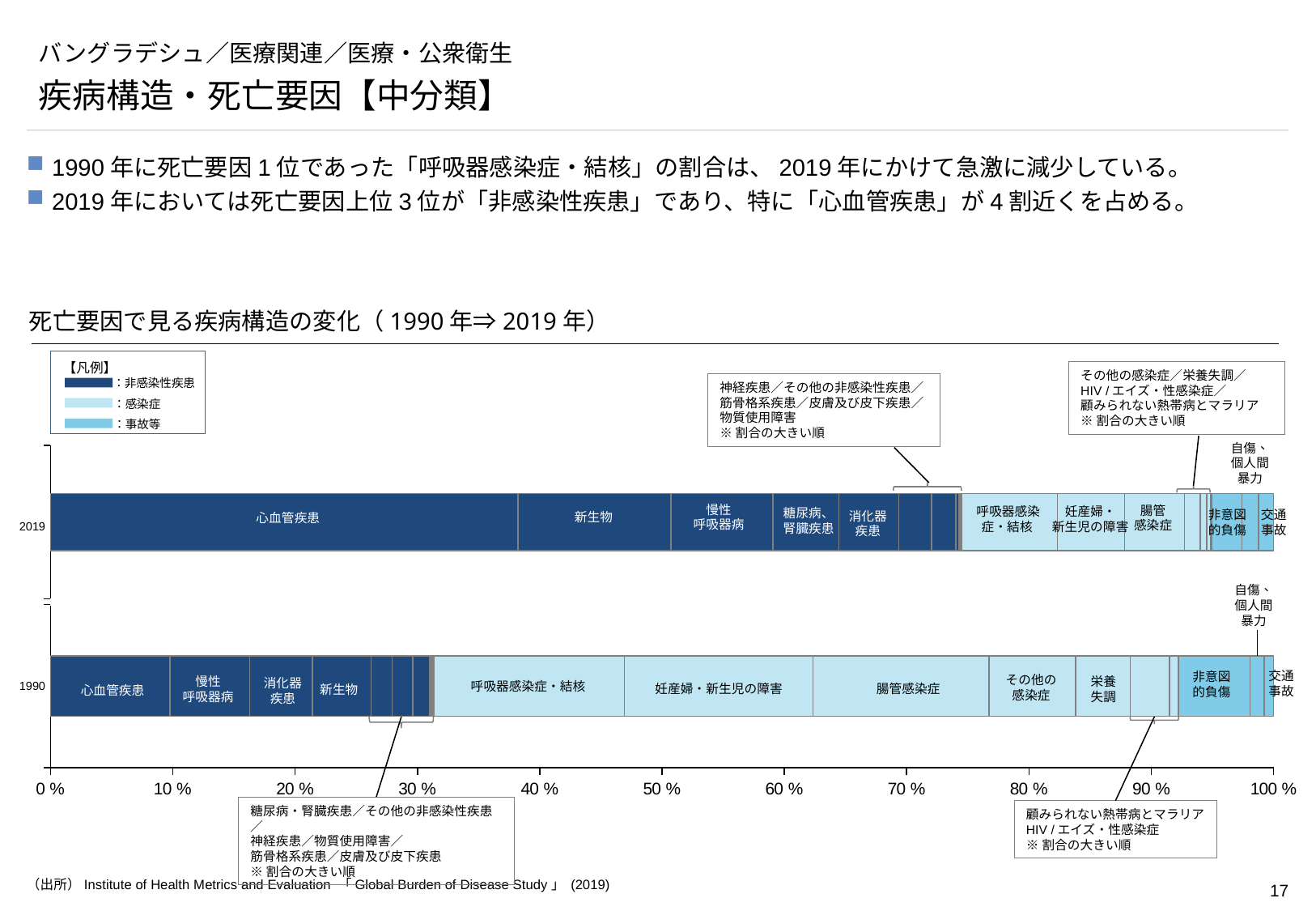
How many years (bars) does the chart compare? 2 Is the share of 心血管疾患 in 2019 greater or less than 40%? less Which is larger: the share of 心血管疾患 in 2019 or in 1990? 2019 Which category does the dark blue colour represent in the legend? 非感染性疾患 Is the share of 心血管疾患 in 1990 greater or less than 20%? less Which cause of death has the largest share in the 2019 bar? 心血管疾患 What kind of chart is shown on the slide? Stacked bar chart According to the slide, which cause of death ranked first in 1990? 呼吸器感染症・結核 How many categories does the legend (凡例) list? 3 Is the share of 心血管疾患 in 2019 greater or less than 30%? greater Did the share of 呼吸器感染症・結核 rise or fall from 1990 to 2019? fall In the 2019 bar, which has the larger share: 新生物 or 慢性呼吸器病? 新生物